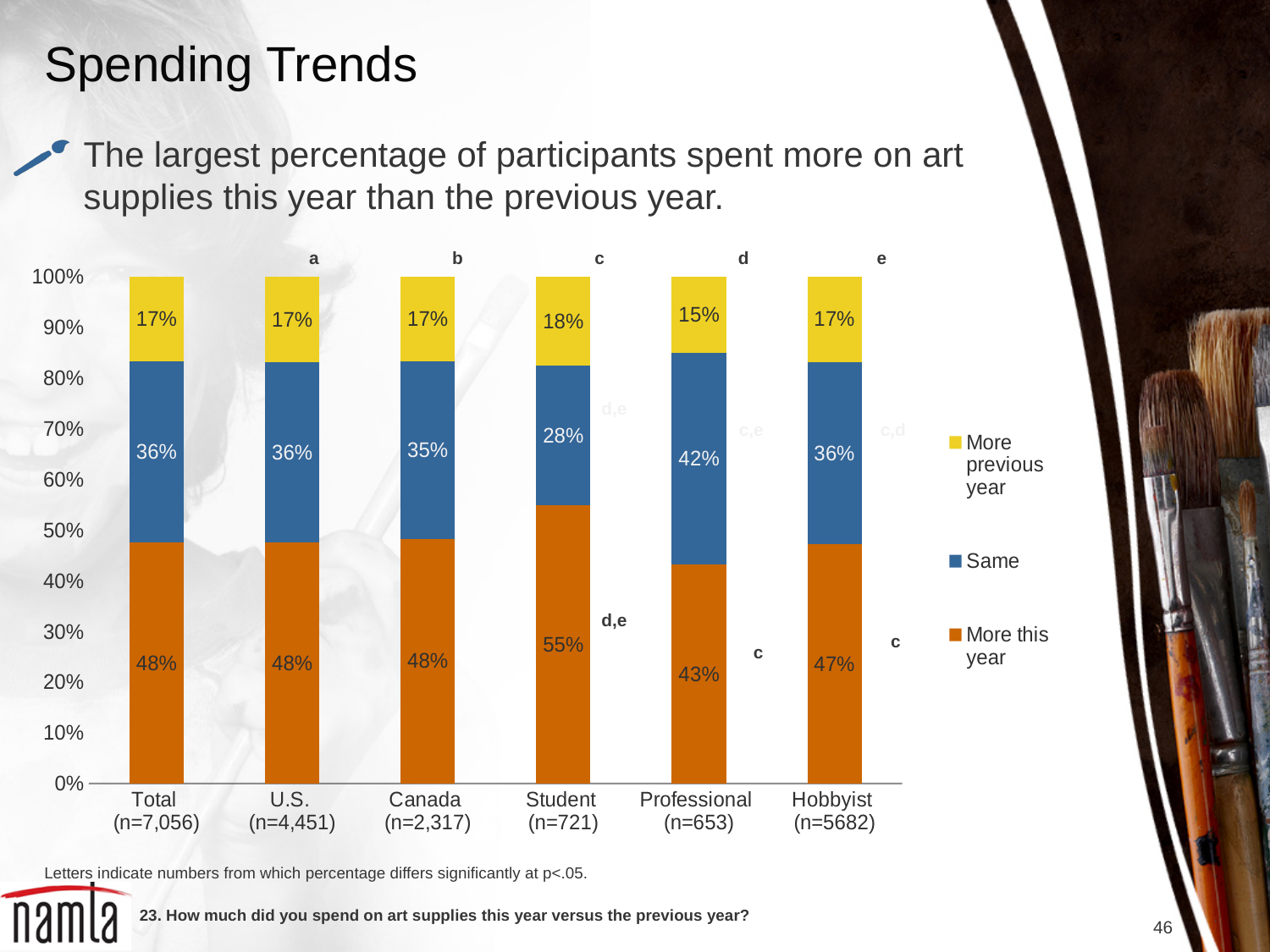
Which is larger: the 'Same' percentage for Professional or for Student? Professional Which colour represents the 'Same' series in the legend? Blue What is the difference between the 'More this year' percentages for Student and Professional? 12% What percentage of Students spent more on art supplies this year? 55% What kind of chart is shown on the slide? Stacked bar chart What percentage of Hobbyists spent more in the previous year? 17% What percentage of Professionals reported spending the same amount? 42% How many categories are shown on the x axis? 6 How many series does the legend list? 3 What is the sample size (n) for the Canada category? 2,317 Which category has the highest percentage for 'More this year'? Student Which category has the lowest percentage for 'More previous year'? Professional